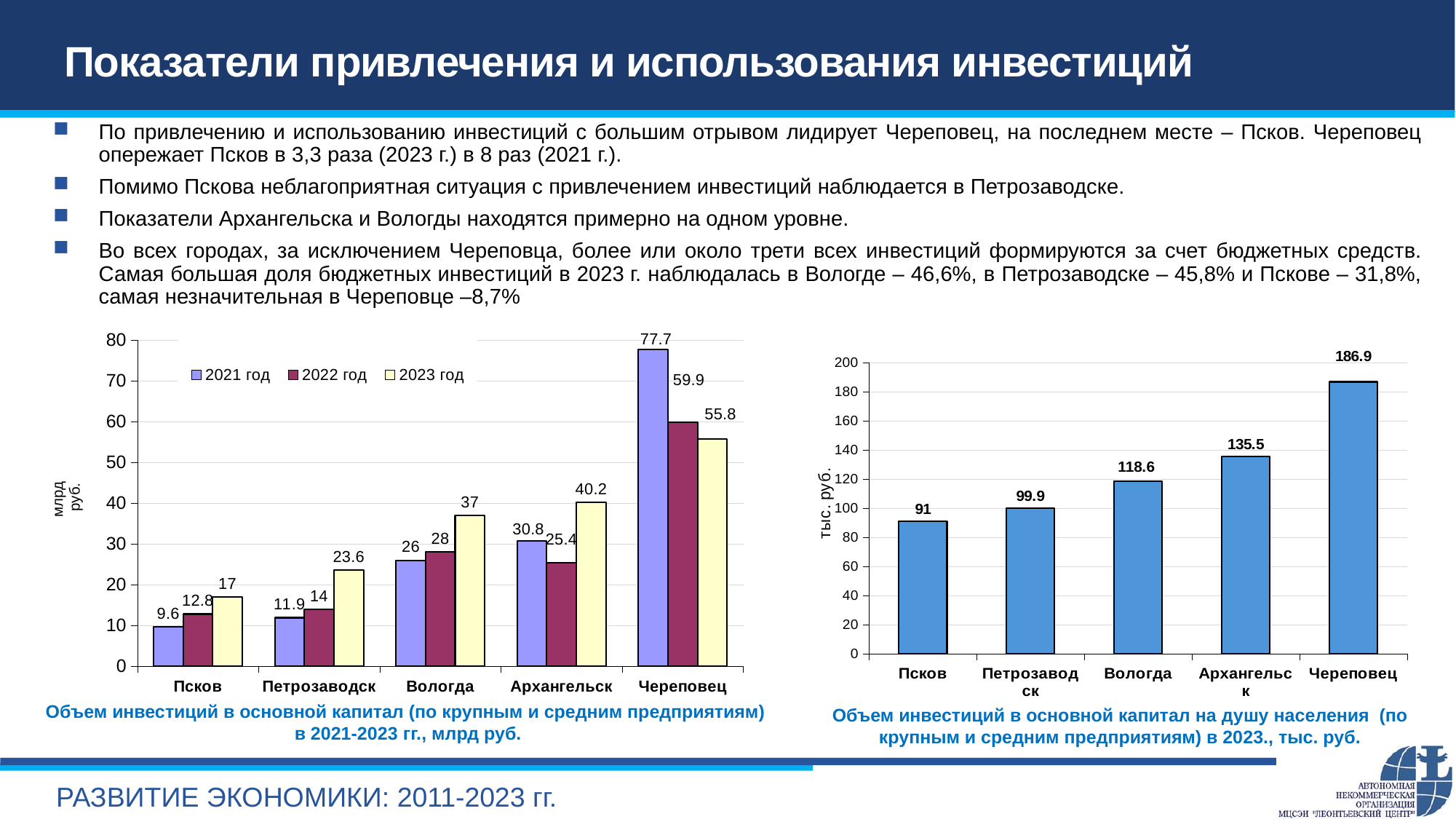
In the left chart, do the values for Череповец rise or fall from 2021 to 2023? fall In the left chart, which is larger for Архангельск: the 2021 value or the 2022 value? 2021 value In the right chart, which city has the highest value? Череповец In the left chart, which city has the lowest value for 2021? Псков In the left chart, what is the difference between the 2023 and 2021 values for Архангельск? 9.4 In the left chart, what is the value for Петрозаводск in 2023? 23.6 In the left chart, how many series does the legend list? 3 In the left chart (Объем инвестиций в основной капитал в 2021-2023 гг.), what is the value for Череповец in 2021? 77.7 In the right chart, how many cities are shown? 5 What type of chart is the right chart? bar chart In the right chart, what is the difference between Череповец and Псков? 95.9 In the right chart (Объем инвестиций в основной капитал на душу населения в 2023 г.), what is the value for Вологда? 118.6